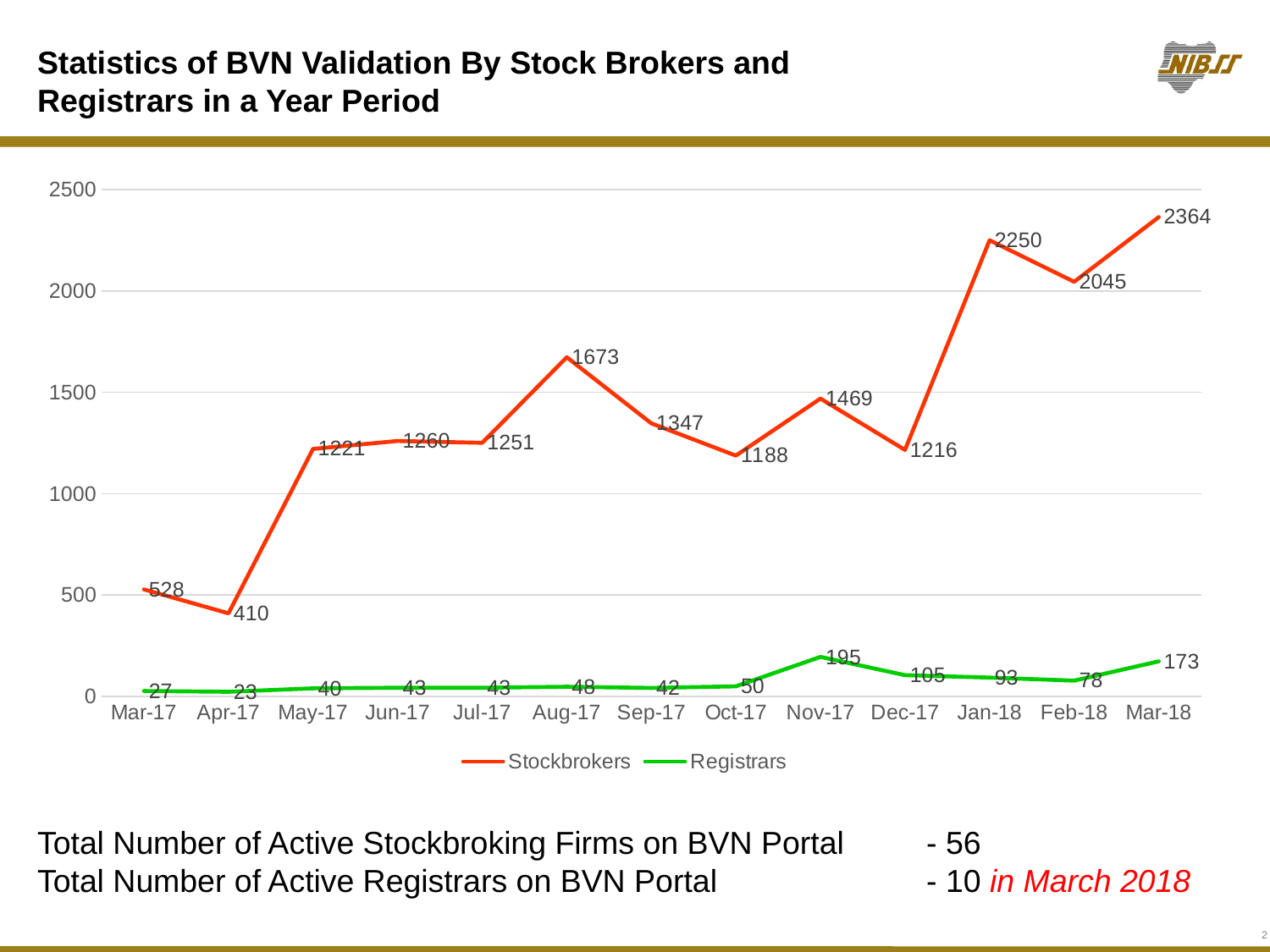
What is the Stockbrokers value for Aug-17? 1673 Which is larger, the Registrars value for Nov-17 or for Mar-18? Nov-17 Is the Stockbrokers value for Dec-17 greater or less than 1500? less What kind of chart is shown on the slide? line chart How many months are plotted on the x axis? 13 What is the difference between the Stockbrokers values for Jan-18 and Feb-18? 205 In which month is the Stockbrokers value lowest? Apr-17 In which month is the Registrars value lowest? Apr-17 How many series does the legend list? 2 In which month is the Stockbrokers value highest? Mar-18 What is the Registrars value for Nov-17? 195 What colour is the Registrars line? green